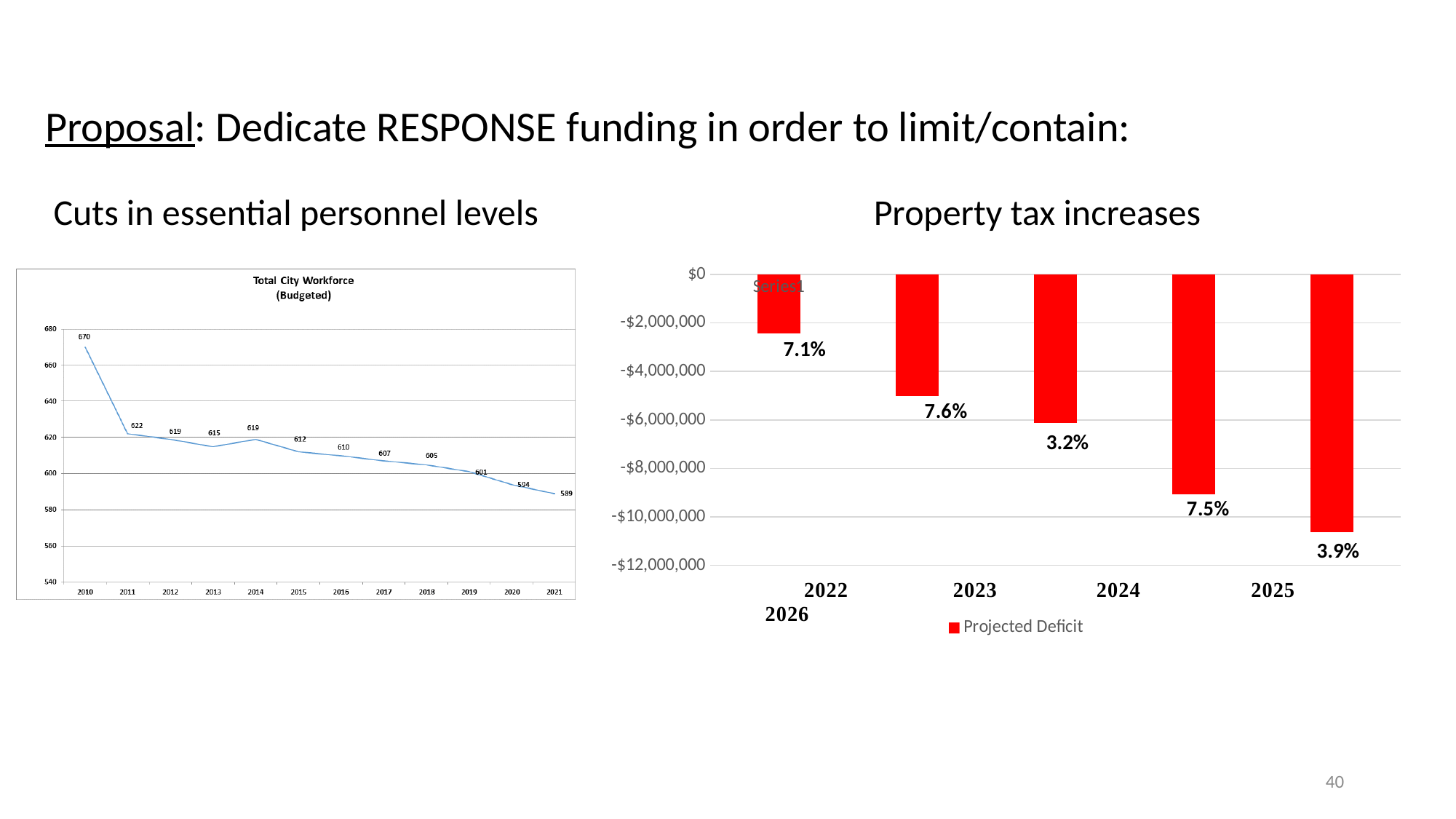
On the Total City Workforce (Budgeted) chart, what is the value for 2015? 612 On the Projected Deficit chart on the right, is the value of the rightmost bar greater or less than -$8,000,000? less On the Total City Workforce (Budgeted) chart, do the values generally rise or fall from 2010 to 2021? fall What kind of chart is the Total City Workforce (Budgeted) chart? line chart On the Total City Workforce (Budgeted) chart, what is the difference between the 2010 value and the 2011 value? 48 On the Total City Workforce (Budgeted) chart, is the value for 2013 or 2014 larger? 2014 On the Total City Workforce (Budgeted) chart, which year has the highest value? 2010 On the Total City Workforce (Budgeted) chart, how many years are plotted? 12 On the Total City Workforce (Budgeted) chart, which year has the lowest value? 2021 What kind of chart is the Projected Deficit chart on the right? bar chart On the Total City Workforce (Budgeted) chart, what is the value for 2010? 670 On the Total City Workforce (Budgeted) chart, what is the value for 2021? 589